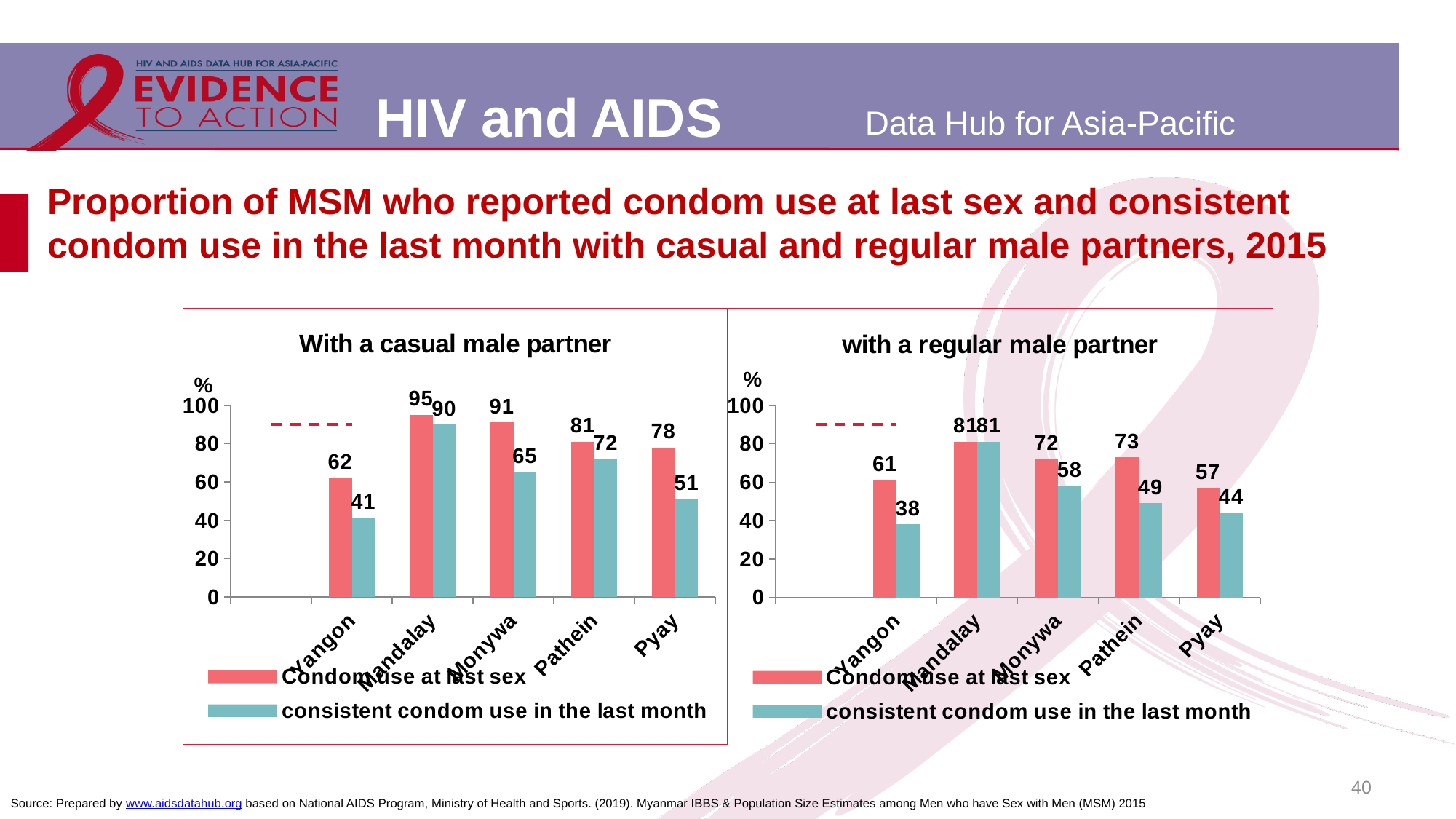
What type of chart is the 'With a casual male partner' chart? Bar chart In the 'with a regular male partner' chart, what is the value for consistent condom use in the last month in Yangon? 38 In the 'With a casual male partner' chart, what is the difference between condom use at last sex and consistent condom use in the last month in Pyay? 27 In the 'with a regular male partner' chart, what is the difference between condom use at last sex in Mandalay and in Pyay? 24 In the 'with a regular male partner' chart, which is larger in Monywa: condom use at last sex or consistent condom use in the last month? Condom use at last sex How many series does the legend of the 'with a regular male partner' chart list? 2 In the 'with a regular male partner' chart, what is the value for condom use at last sex in Pathein? 73 How many cities are shown on the x axis of the 'With a casual male partner' chart? 5 In the 'With a casual male partner' chart, what is the value for condom use at last sex in Yangon? 62 In the 'With a casual male partner' chart, which city has the highest value for condom use at last sex? Mandalay In the 'with a regular male partner' chart, which city has the lowest value for consistent condom use in the last month? Yangon In the 'With a casual male partner' chart, what is the value for consistent condom use in the last month in Monywa? 65